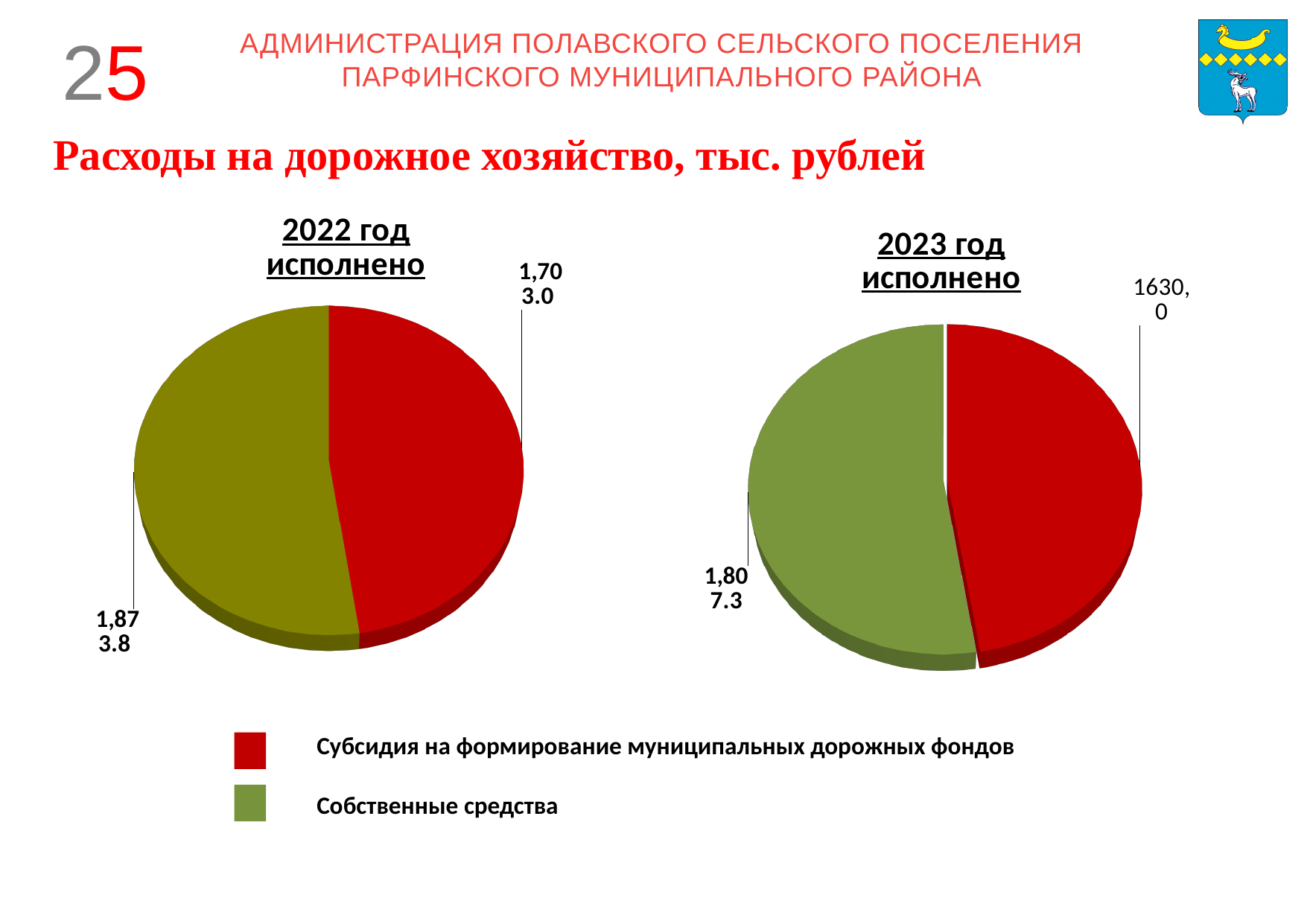
How many slices does the 2022 год исполнено pie chart have? 2 In the 2022 год исполнено pie chart, what is the difference between Собственные средства and Субсидия на формирование муниципальных дорожных фондов? 170.8 Which colour represents Собственные средства in the legend? Green What kind of chart is used for 2023 год исполнено? Pie chart In the 2022 год исполнено pie chart, which category has the larger value? Собственные средства In the 2023 год исполнено pie chart, what is the total of the two slices? 3437.3 In the 2022 год исполнено pie chart, what is the value for Собственные средства? 1,873.8 Is the value for Субсидия на формирование муниципальных дорожных фондов larger in the 2022 год исполнено chart or the 2023 год исполнено chart? 2022 год исполнено In the 2023 год исполнено pie chart, what is the value for Субсидия на формирование муниципальных дорожных фондов? 1630,0 In the 2023 год исполнено pie chart, what is the value for Собственные средства? 1,807.3 In the 2023 год исполнено pie chart, which category has the smaller value? Субсидия на формирование муниципальных дорожных фондов In the 2022 год исполнено pie chart, what is the value for Субсидия на формирование муниципальных дорожных фондов? 1,703.0